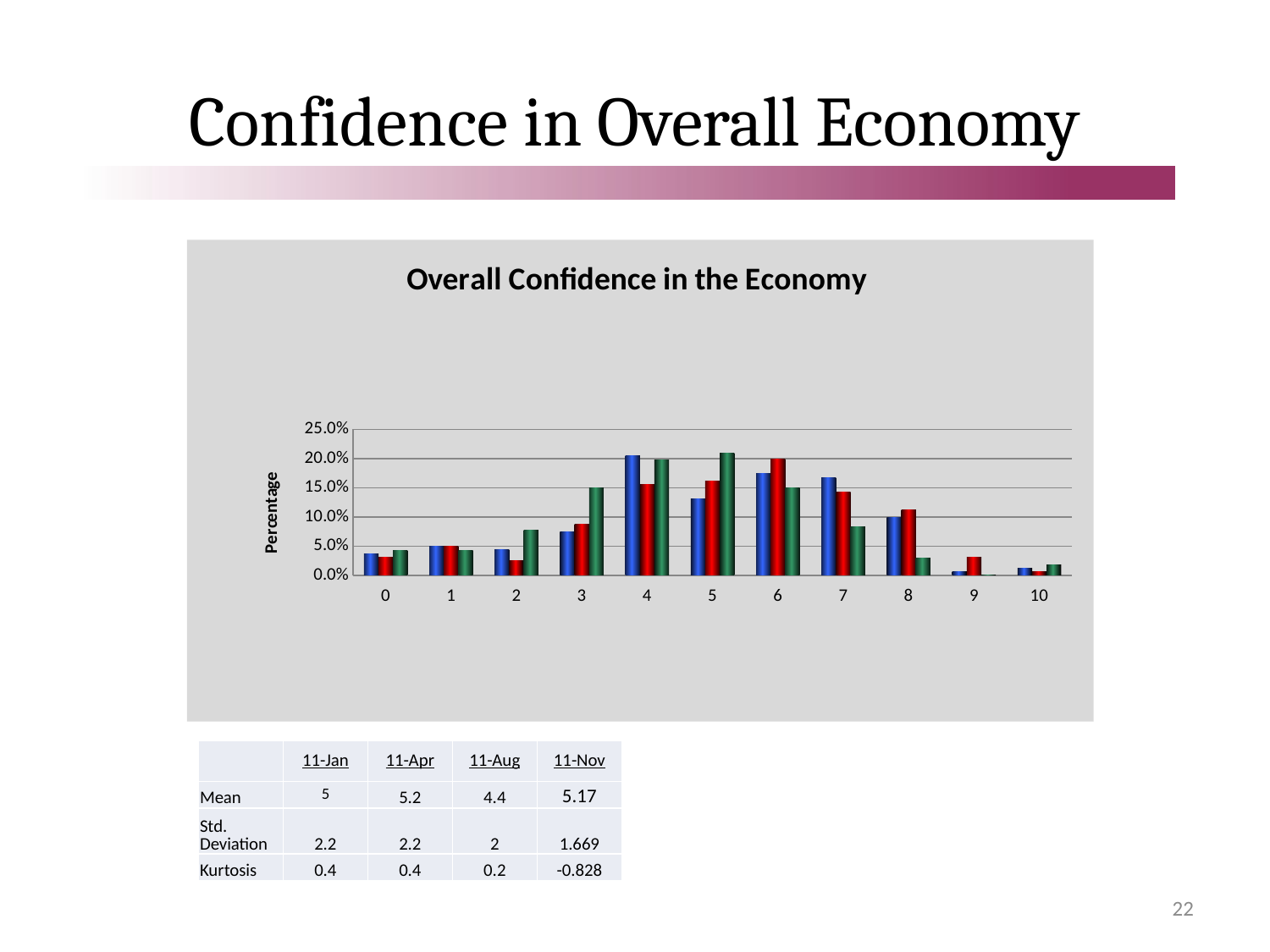
For category 3, which bar is larger, the green bar or the blue bar? green What is the label on the vertical axis of the chart? Percentage Is the value of the green bar for category 8 greater or less than 5.0%? less For which category does the red series reach its highest value? 6 Is the value of the blue bar for category 4 greater or less than 15.0%? greater What is the title of the chart? Overall Confidence in the Economy What kind of chart is shown on the slide? bar chart Is the value of the blue bar for category 5 greater or less than 10.0%? greater For category 7, which bar is larger, the blue bar or the green bar? blue How many categories are shown along the x axis of the chart? 11 How many bars are plotted for each category on the x axis? 3